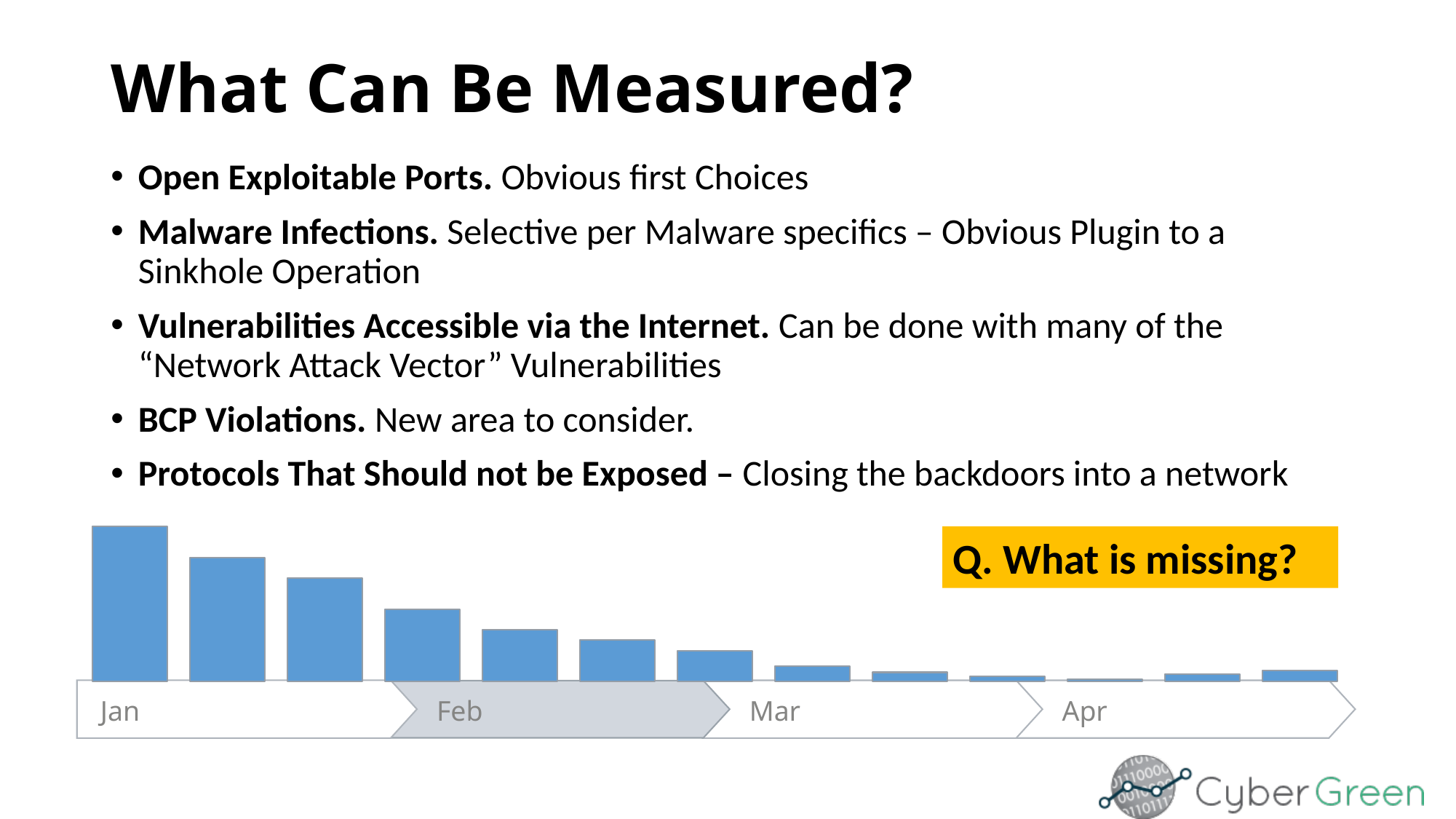
Do the bar heights in the chart generally rise or fall from left to right? fall Does the chart display any data labels or axis values? No Which is taller, the leftmost bar or the rightmost bar? the leftmost bar Which is taller, the fourth bar or the seventh bar from the left? the fourth bar How many bars does the chart at the bottom of the slide contain? 13 Which bar in the chart is the shortest? the eleventh bar from the left What kind of chart is shown at the bottom of the slide? bar chart Which bar in the chart is the tallest? the leftmost (first) bar Which is taller, the first bar or the second bar from the left? the first bar What colour are the bars in the chart? blue